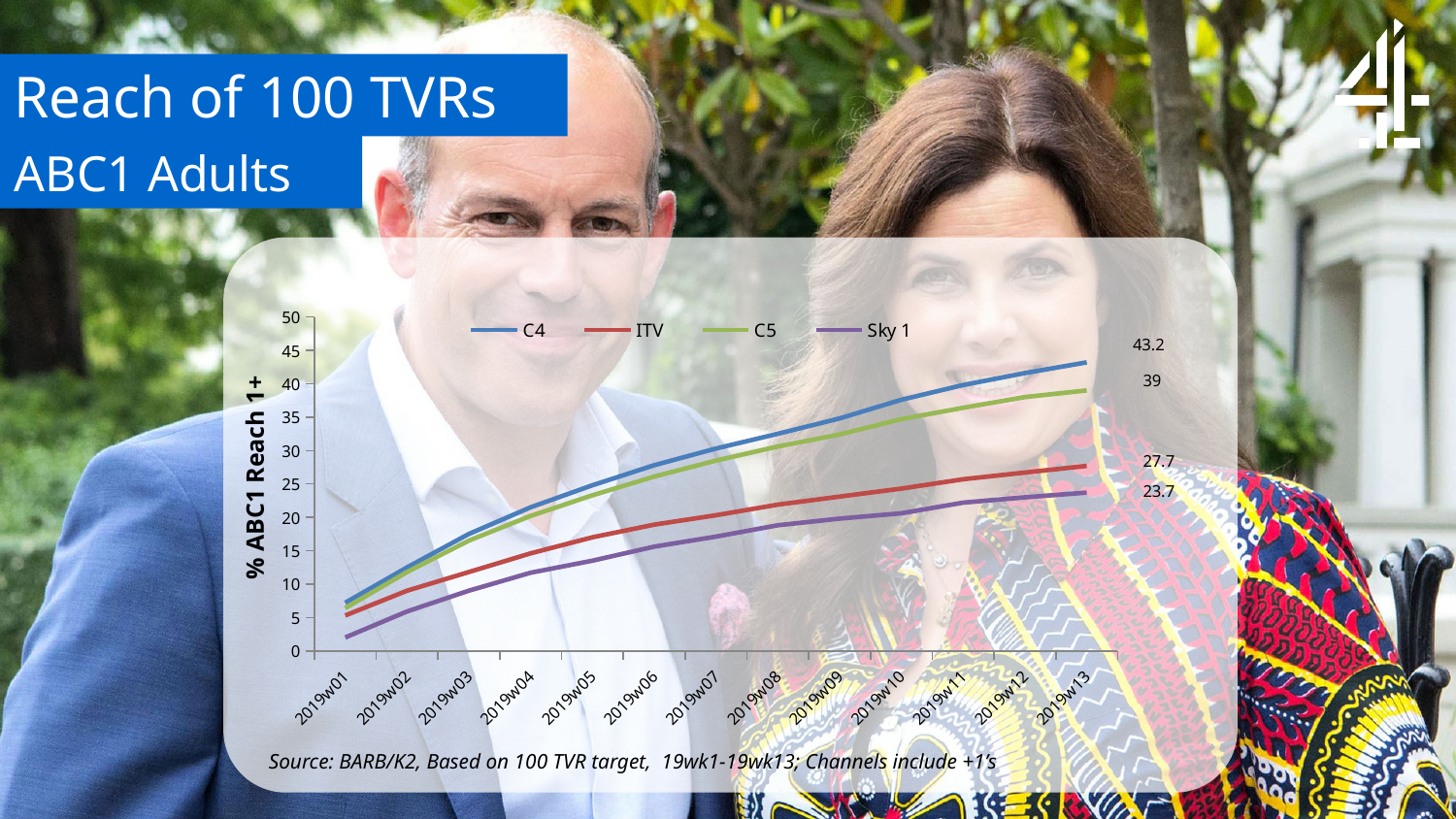
What is the value for Sky 1 at 2019w13? 23.7 What is the value for C5 at 2019w13? 39 What is the value for ITV at 2019w13? 27.7 What is the value for C4 at 2019w13? 43.2 How many weeks are plotted along the x axis of the chart? 13 Does the C4 line rise or fall from 2019w01 to 2019w13? rise Is the value for Sky 1 at 2019w01 greater or less than 5? less Which channel has the highest reach at 2019w13? C4 What kind of chart is shown on the slide? line chart What is the difference between the C4 and C5 values at 2019w13? 4.2 Which channel has the lowest reach at 2019w13? Sky 1 How many series does the chart legend list? 4